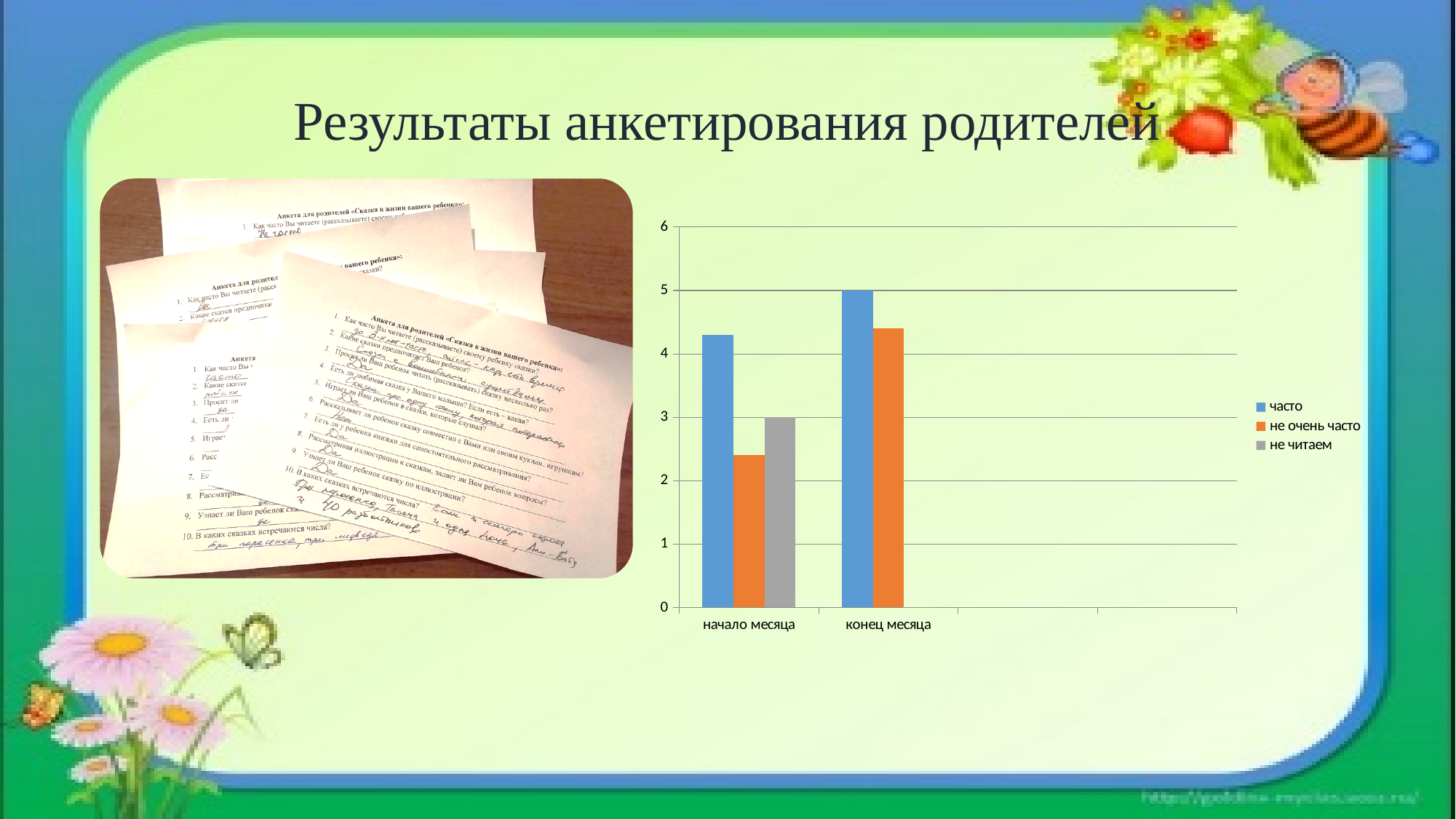
What is the value for "не читаем" at "начало месяца"? 3 How many categories are shown on the x axis of the chart? 2 What kind of chart is shown on the slide? bar chart Which is larger: the value for "часто" at "начало месяца" or at "конец месяца"? конец месяца Which series has the highest value at "конец месяца"? часто How many series does the chart legend list? 3 Is the value for "не очень часто" at "начало месяца" greater or less than 3? less What is the value for "часто" at "конец месяца"? 5 Which colour represents the series "не читаем" in the legend? grey Is the value for "часто" at "начало месяца" greater or less than 4? greater Which series has the lowest value at "начало месяца"? не очень часто Is the value for "не очень часто" at "конец месяца" greater or less than 4? greater